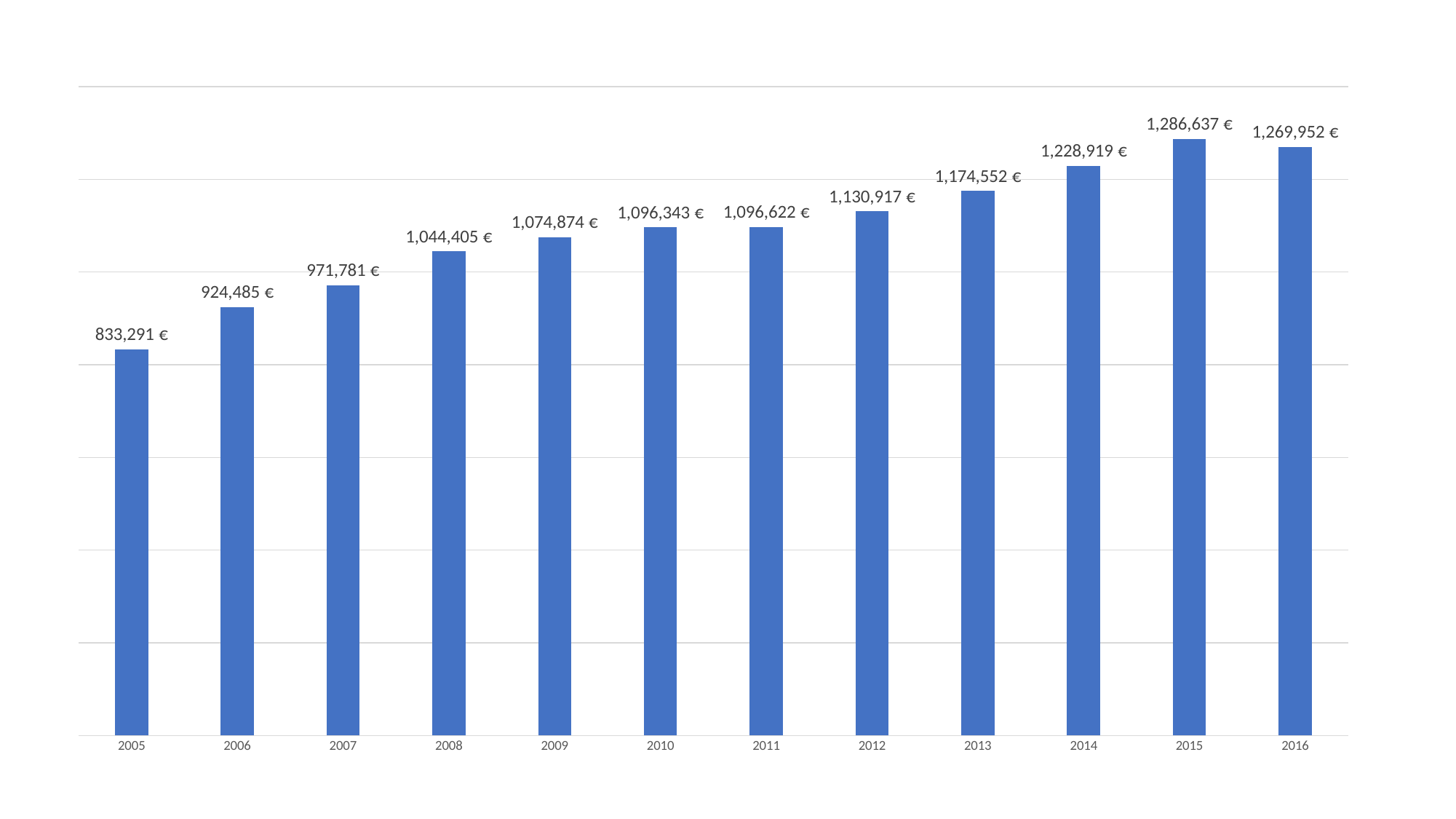
Which year has the lowest value? 2005 What colour are the bars in the chart? Blue What is the value for 2005? 833,291 € What is the difference between the values for 2006 and 2005? 91,194 € How many years are shown on the x axis of the chart? 12 Do the values generally rise or fall from 2005 to 2015? Rise What is the difference between the values for 2015 and 2016? 16,685 € What kind of chart is shown on the slide? Bar chart Which is larger, the value for 2014 or the value for 2016? 2016 Which year has the highest value? 2015 What is the value for 2016? 1,269,952 € What is the value for 2012? 1,130,917 €